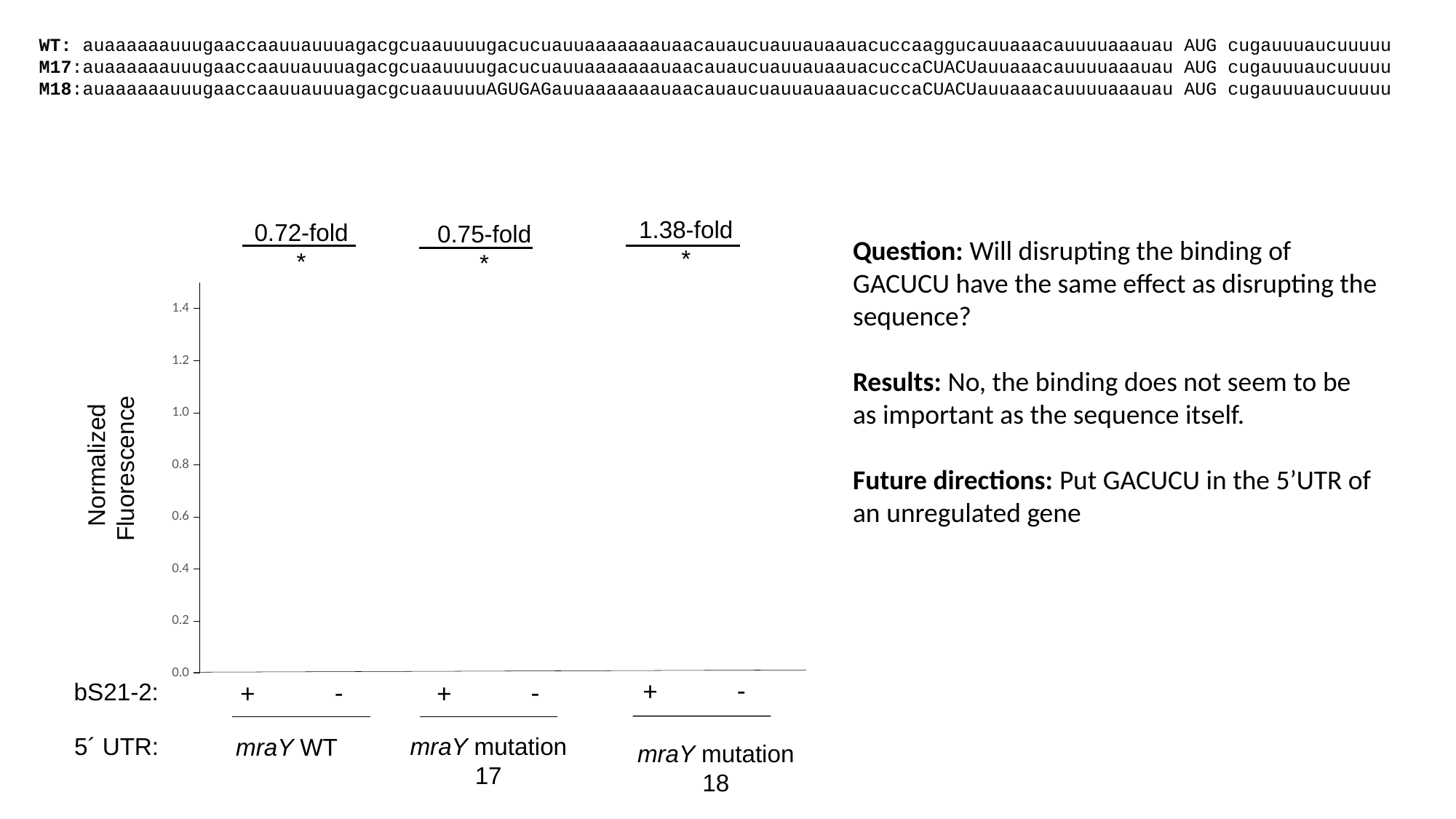
What is the highest tick value shown on the y axis? 1.4 Which 5' UTR group has the lowest annotated fold change? mraY WT What is the difference between the annotated fold changes for mraY mutation 18 and mraY WT? 0.66-fold Which 5' UTR group has the highest annotated fold change? mraY mutation 18 What fold change is annotated above the mraY WT group? 0.72-fold Is the annotated fold change for mraY mutation 18 larger or smaller than that for mraY WT? larger How many 5' UTR groups are shown along the x axis? 3 What fold change is annotated above the mraY mutation 18 group? 1.38-fold What is the label of the y axis? Normalized Fluorescence How many bS21-2 conditions (+ and -) are shown in total along the x axis? 6 What fold change is annotated above the mraY mutation 17 group? 0.75-fold